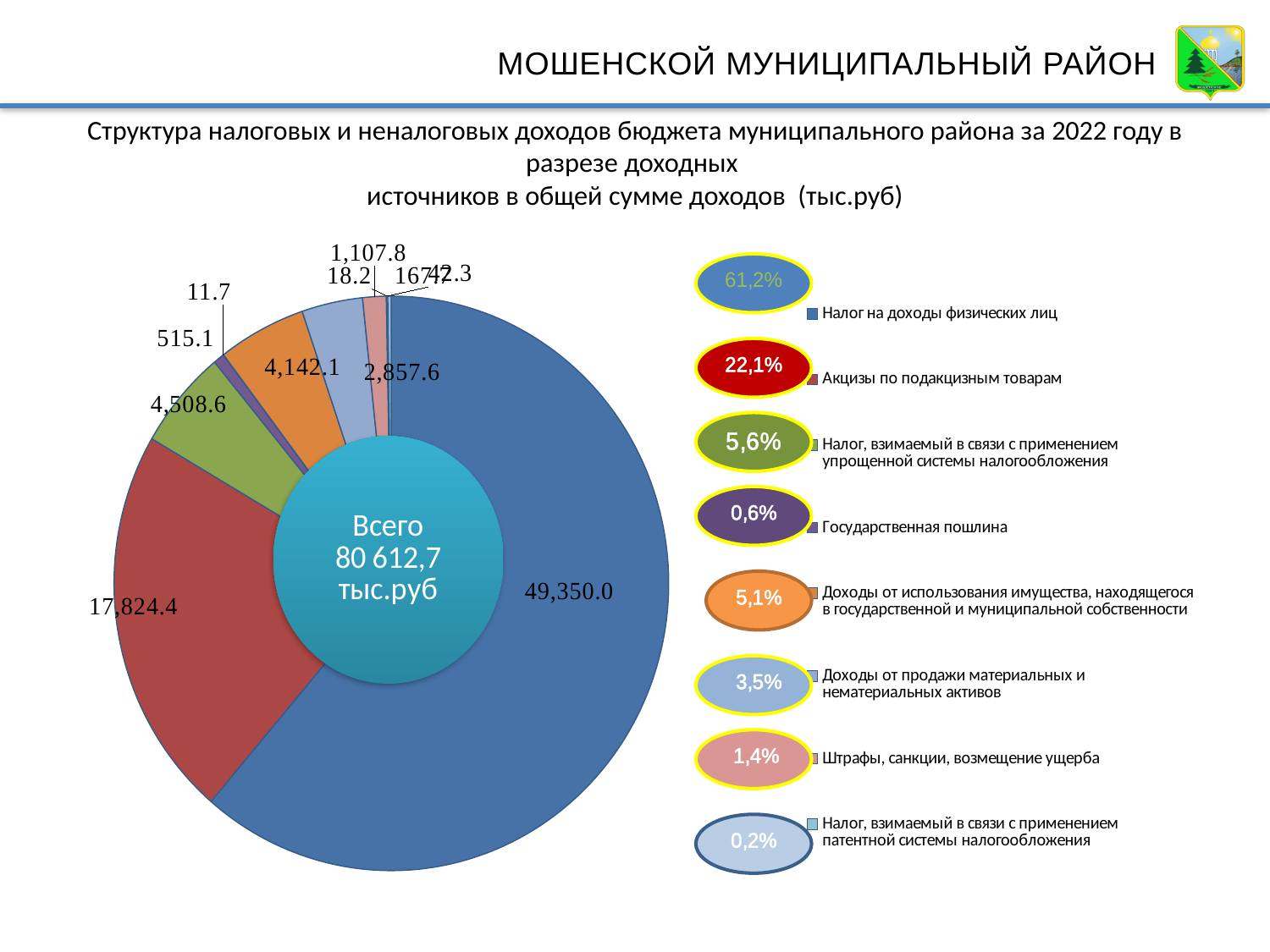
Which is larger: the value for Налог, взимаемый в связи с применением упрощенной системы налогообложения or the value for Доходы от использования имущества, находящегося в государственной и муниципальной собственности? Налог, взимаемый в связи с применением упрощенной системы налогообложения What kind of chart is shown on the slide? pie chart What is the value for Акцизы по подакцизным товарам? 17,824.4 Which category has the largest slice of the pie? Налог на доходы физических лиц What is the value for Доходы от продажи материальных и нематериальных активов? 2,857.6 How many entries does the legend list? 8 What is the difference between the value for Налог на доходы физических лиц and the value for Акцизы по подакцизным товарам? 31,525.6 What is the value for Налог на доходы физических лиц? 49,350.0 What is the value for Штрафы, санкции, возмещение ущерба? 1,107.8 What share of the pie does Акцизы по подакцизным товарам represent? 22,1% What is the value for Государственная пошлина? 515.1 What share of the pie does Налог, взимаемый в связи с применением упрощенной системы налогообложения represent? 5,6%